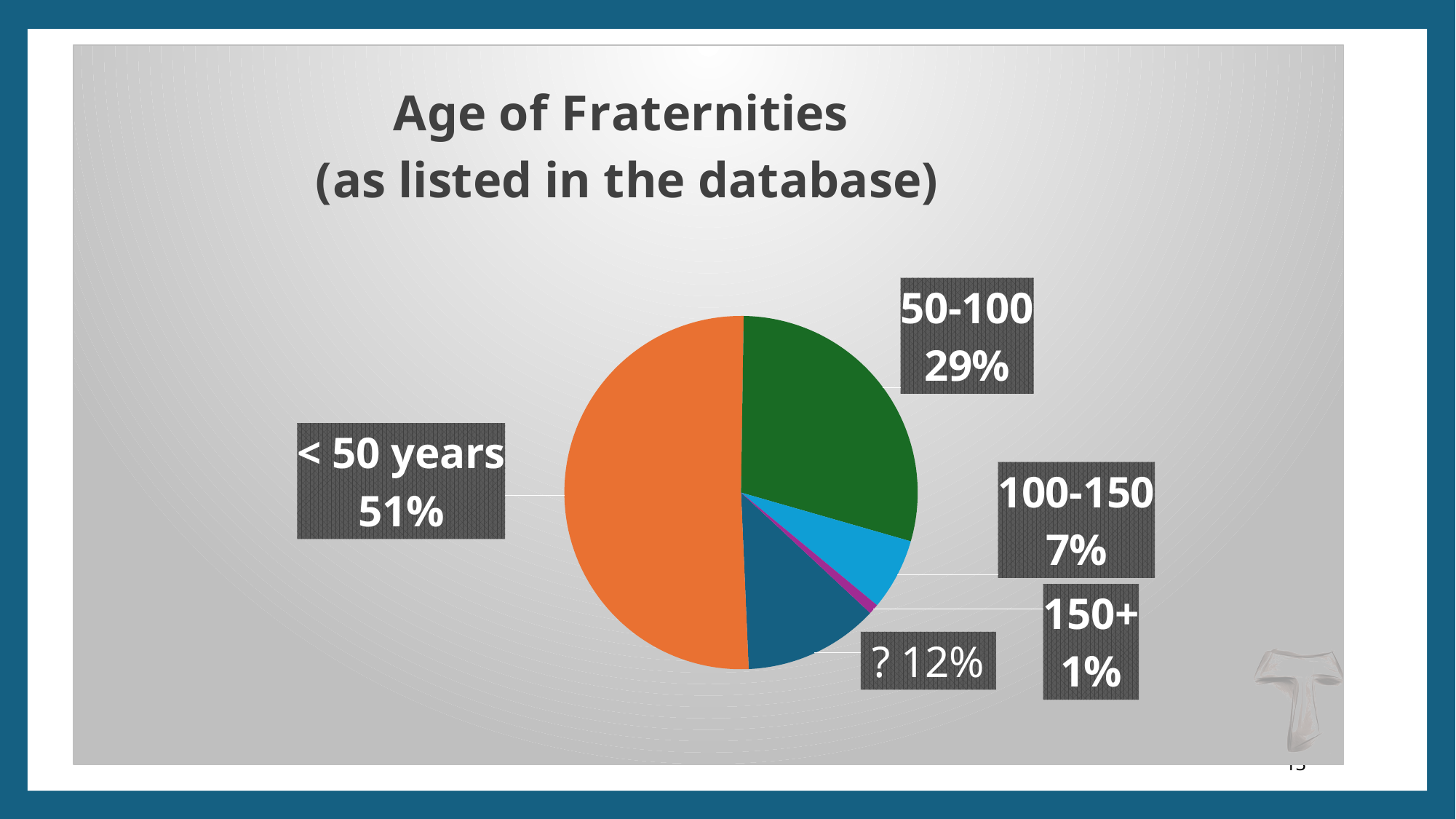
How many slices does the pie chart have? 5 What is the title of the chart? Age of Fraternities (as listed in the database) Which category has the largest slice of the pie? < 50 years What share of the pie is the '100-150' slice? 7% What share of the pie is the '50-100' slice? 29% What share of the pie is the '150+' slice? 1% Which category has the smallest slice of the pie? 150+ What is the difference in percentage points between the '< 50 years' slice and the '50-100' slice? 22 What kind of chart is shown on the slide? pie chart Which is larger, the '?' slice or the '100-150' slice? ?